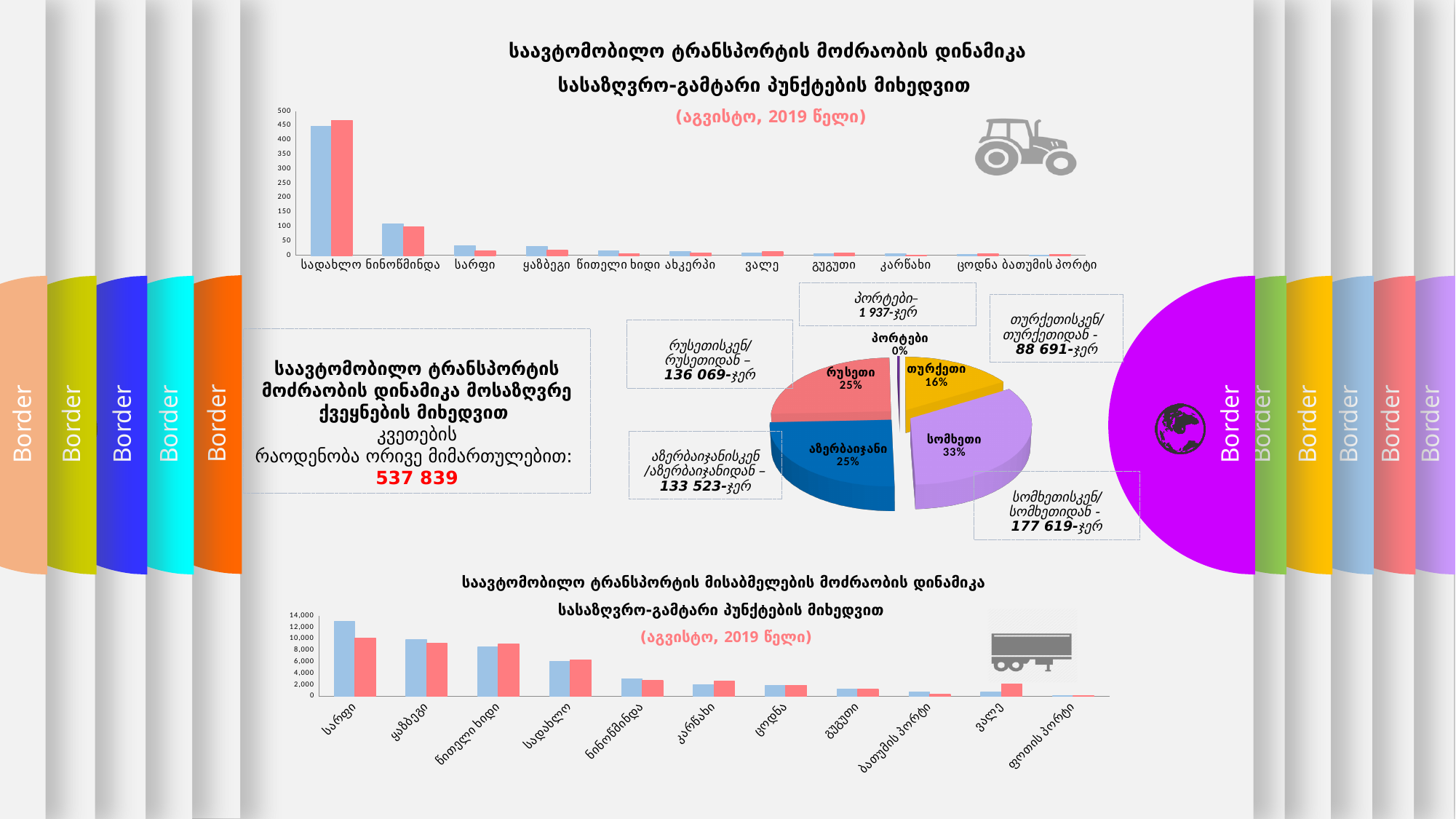
How many categories are shown on the x axis of the bottom bar chart? 11 In the top bar chart, is the blue bar for სადახლო greater or less than 400? greater According to the callout next to the pie chart, how many times was the სომხეთისკენ/სომხეთიდან direction recorded? 177 619-ჯერ In the pie chart, which slice is the largest? სომხეთი In the pie chart, what share does სომხეთი have? 33% In the pie chart, what is the difference in percentage points between სომხეთი and თურქეთი? 17% In the bottom bar chart, is the blue bar for სარფი greater or less than 12,000? greater What kind of chart is the middle chart on the slide? pie chart How many categories are shown on the x axis of the top bar chart? 11 In the top bar chart, which category has the highest bars? სადახლო In the pie chart, which slice is the smallest? პორტები What kind of chart is the top chart on the slide? bar chart